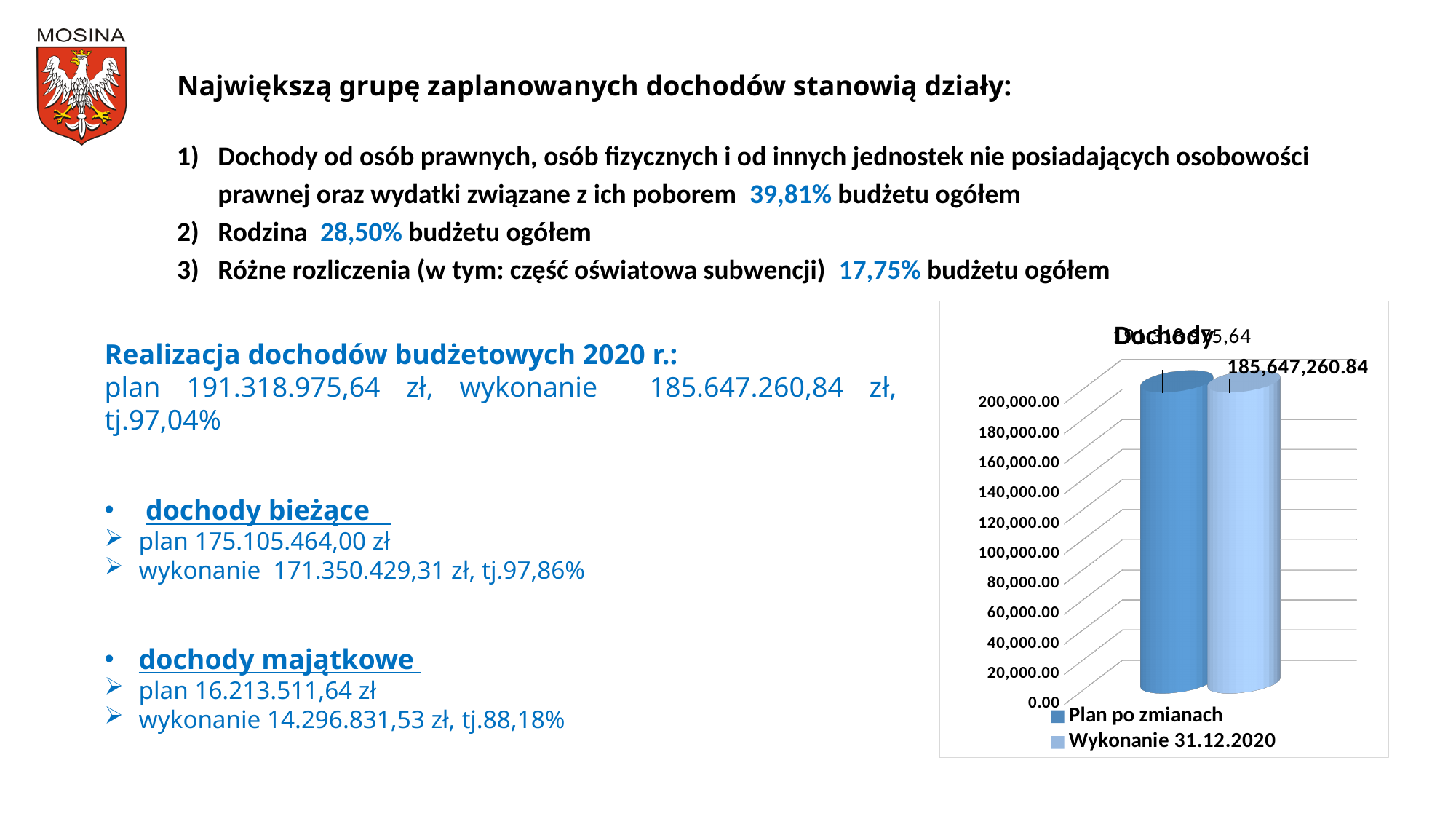
How many bars are plotted in the chart? 2 What is the title of the chart? Dochody What is the highest tick value shown on the chart's vertical axis? 200,000.00 What are the two series named in the chart legend? Plan po zmianach; Wykonanie 31.12.2020 Is the value of the Plan po zmianach bar greater or less than 160,000.00 on the axis? greater How many series does the chart legend list? 2 What kind of chart is shown on the slide? bar chart What value is labelled on the Wykonanie 31.12.2020 bar? 185,647,260.84 Is the value of the Wykonanie 31.12.2020 bar greater or less than 140,000.00 on the axis? greater